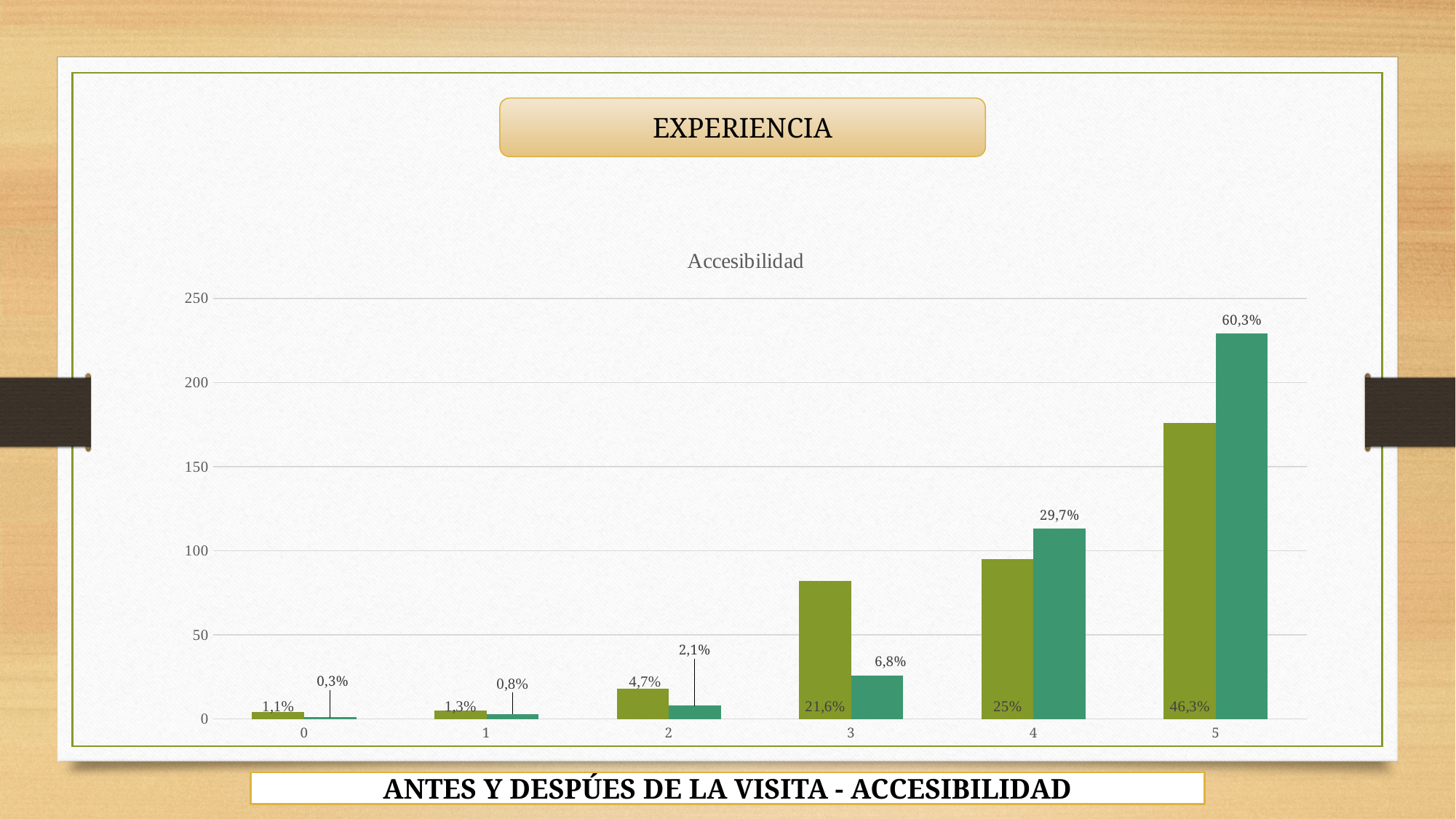
Is the olive (left) bar for category 4 greater or less than 100 on the y axis? less What is the data label on the teal (right) bar for category 5? 60,3% For category 4, which bar is taller, the olive (left) bar or the teal (right) bar? the teal (right) bar What is the data label on the olive (left) bar for category 3? 21,6% Do the teal (right) bars rise or fall as the categories go from 0 to 5? rise What kind of chart is shown on the slide? bar chart What is the title of the chart? Accesibilidad Is the teal (right) bar for category 5 greater or less than 200 on the y axis? greater How many categories are shown along the x axis of the chart? 6 For category 3, which bar is taller, the olive (left) bar or the teal (right) bar? the olive (left) bar What is the data label on the teal (right) bar for category 0? 0,3% Which category has the tallest teal (right) bar? 5